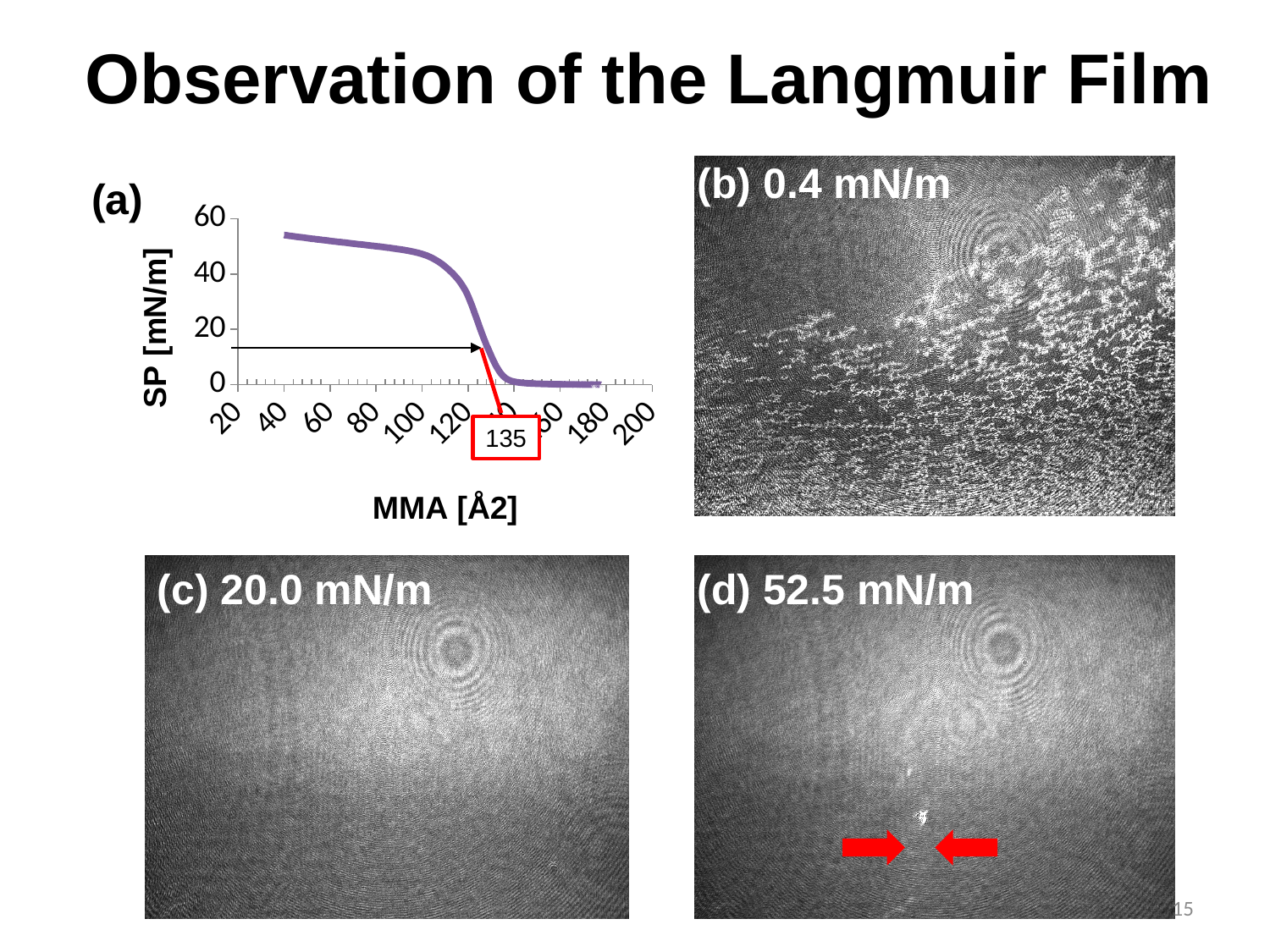
What is the y-axis label of chart (a)? SP [mN/m] In chart (a), is the SP value at MMA 100 greater or less than 40? greater In chart (a), is the SP value at MMA 180 greater or less than 20? less In chart (a), is the SP value at MMA 160 greater or less than 20? less In chart (a), which has the larger SP value: MMA 60 or MMA 160? MMA 60 What is the highest value shown on the y axis of chart (a)? 60 In chart (a), what MMA value is marked by the red callout box on the curve? 135 What kind of chart is chart (a)? line chart In chart (a), does SP rise or fall as MMA increases along the x axis? fall How many tick labels are shown on the x axis of chart (a)? 10 What is the x-axis label of chart (a)? MMA [Å2]